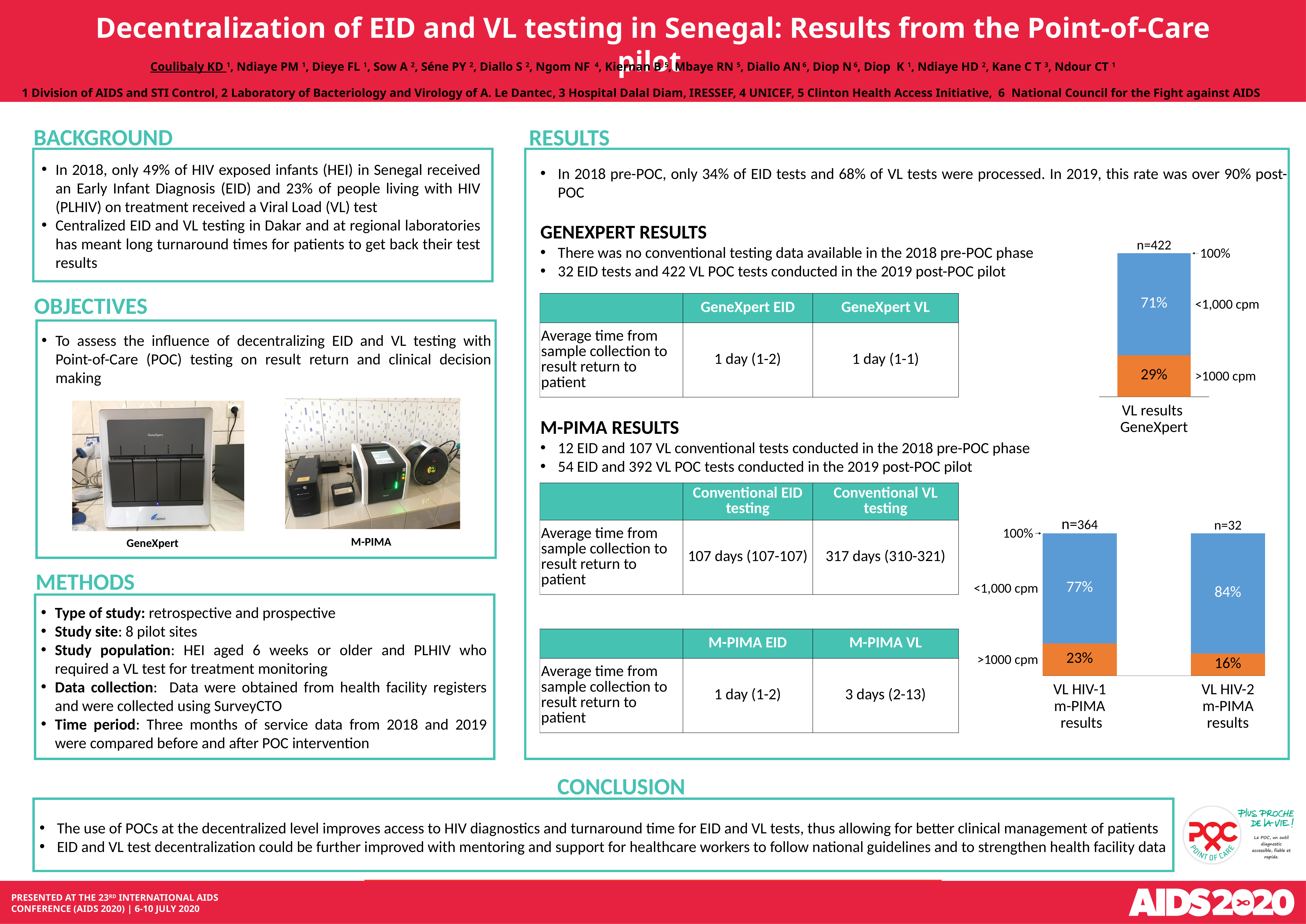
In the m-PIMA results chart, what is the sample size (n) for VL HIV-2? n=32 In the m-PIMA results chart, what is the total of the VL HIV-1 stacked bar? 100% In the m-PIMA results chart, what percentage of VL HIV-1 results were <1,000 cpm? 77% In the m-PIMA results chart, what is the difference between the >1000 cpm shares of VL HIV-1 and VL HIV-2? 7% In the VL results GeneXpert chart, what is the sample size (n) shown above the bar? n=422 In the VL results GeneXpert chart, what percentage of results were <1,000 cpm? 71% In the m-PIMA results chart, what percentage of VL HIV-2 results were >1000 cpm? 16% What type of chart is the VL results GeneXpert chart? Stacked bar chart In the m-PIMA results chart, which bar has the larger <1,000 cpm share, VL HIV-1 or VL HIV-2? VL HIV-2 In the m-PIMA results chart, how many bars are plotted? 2 In the VL results GeneXpert chart, what percentage of results were >1000 cpm? 29% In the VL results GeneXpert chart, what is the difference between the <1,000 cpm share and the >1000 cpm share? 42%